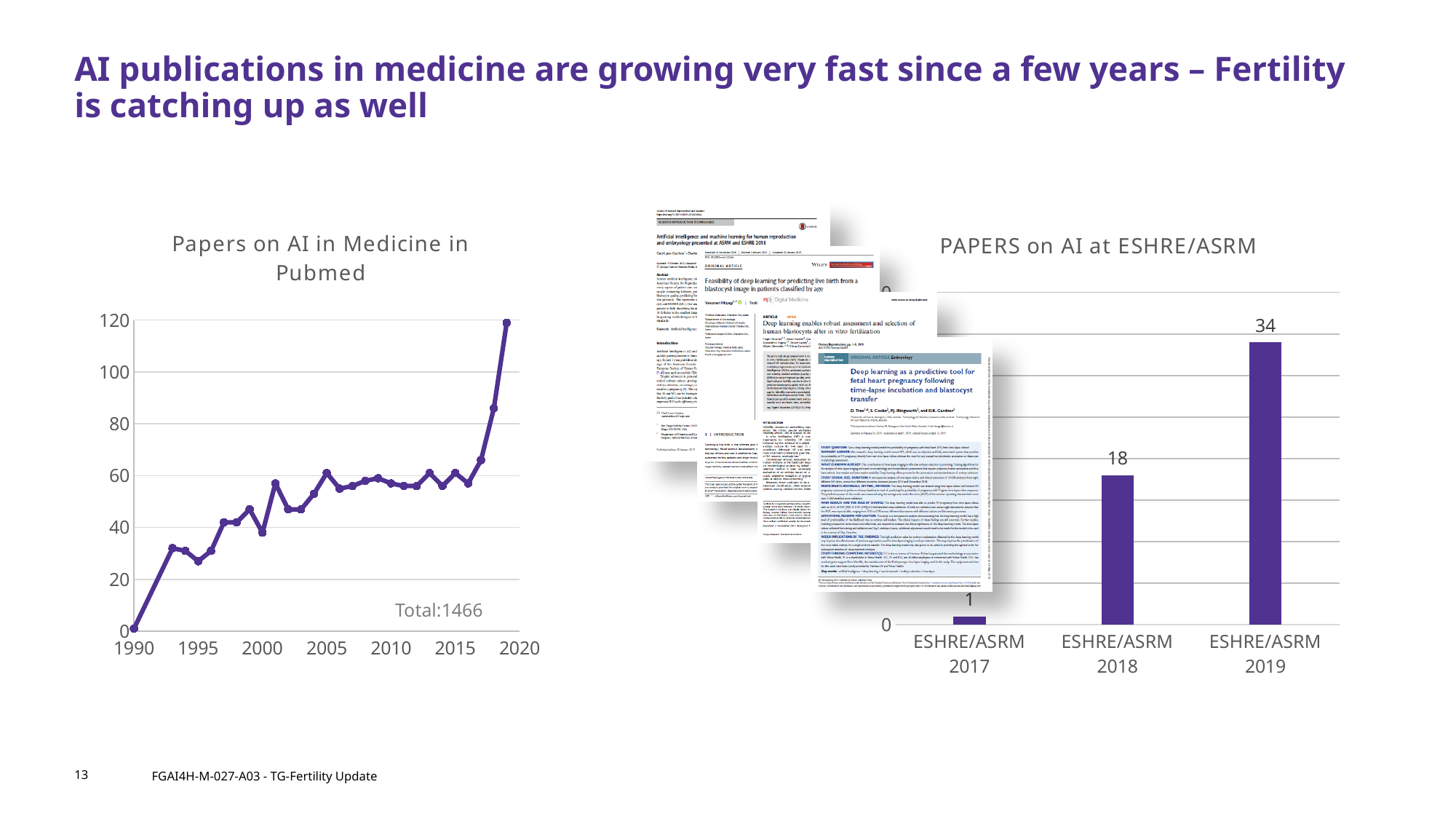
In the 'Papers on AI in Medicine in Pubmed' chart, is the value for 2005 greater or less than 40? greater What total is printed on the 'Papers on AI in Medicine in Pubmed' chart? Total:1466 What kind of chart is 'PAPERS on AI at ESHRE/ASRM'? bar chart In the 'PAPERS on AI at ESHRE/ASRM' chart, what is the value for ESHRE/ASRM 2019? 34 In the 'PAPERS on AI at ESHRE/ASRM' chart, how many categories are shown? 3 In the 'PAPERS on AI at ESHRE/ASRM' chart, what is the difference between the values for ESHRE/ASRM 2019 and ESHRE/ASRM 2018? 16 In the 'PAPERS on AI at ESHRE/ASRM' chart, what is the value for ESHRE/ASRM 2017? 1 What kind of chart is 'Papers on AI in Medicine in Pubmed'? line chart In the 'PAPERS on AI at ESHRE/ASRM' chart, what is the value for ESHRE/ASRM 2018? 18 In the 'PAPERS on AI at ESHRE/ASRM' chart, which category has the highest value? ESHRE/ASRM 2019 In the 'Papers on AI in Medicine in Pubmed' chart, do the values overall rise or fall from 1990 to 2020? rise In the 'PAPERS on AI at ESHRE/ASRM' chart, which category has the lowest value? ESHRE/ASRM 2017